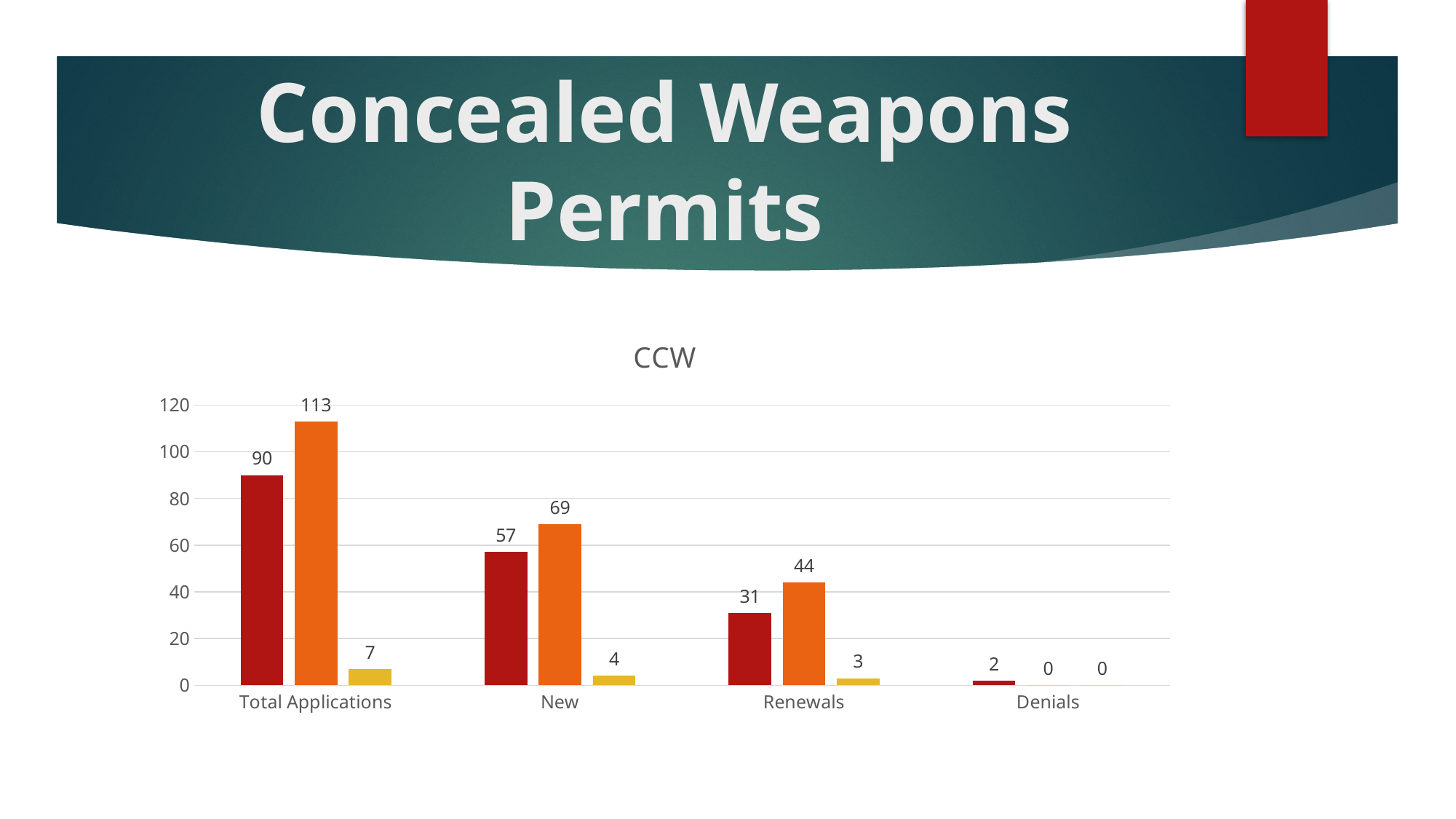
What is the value of the dark red bar for New? 57 What is the difference between the orange bar and the dark red bar for Total Applications? 23 What is the value of the yellow bar for Renewals? 3 Which category has the highest orange bar? Total Applications What is the value of the dark red bar for Denials? 2 Do the dark red bar values rise or fall from Total Applications to Denials along the x axis? fall What kind of chart is shown on the slide? bar chart For Renewals, which is larger: the dark red bar or the orange bar? the orange bar What is the value of the orange bar for Total Applications? 113 How many categories are shown on the x axis of the CCW chart? 4 Which category has the lowest dark red bar? Denials What is the chart's title? CCW